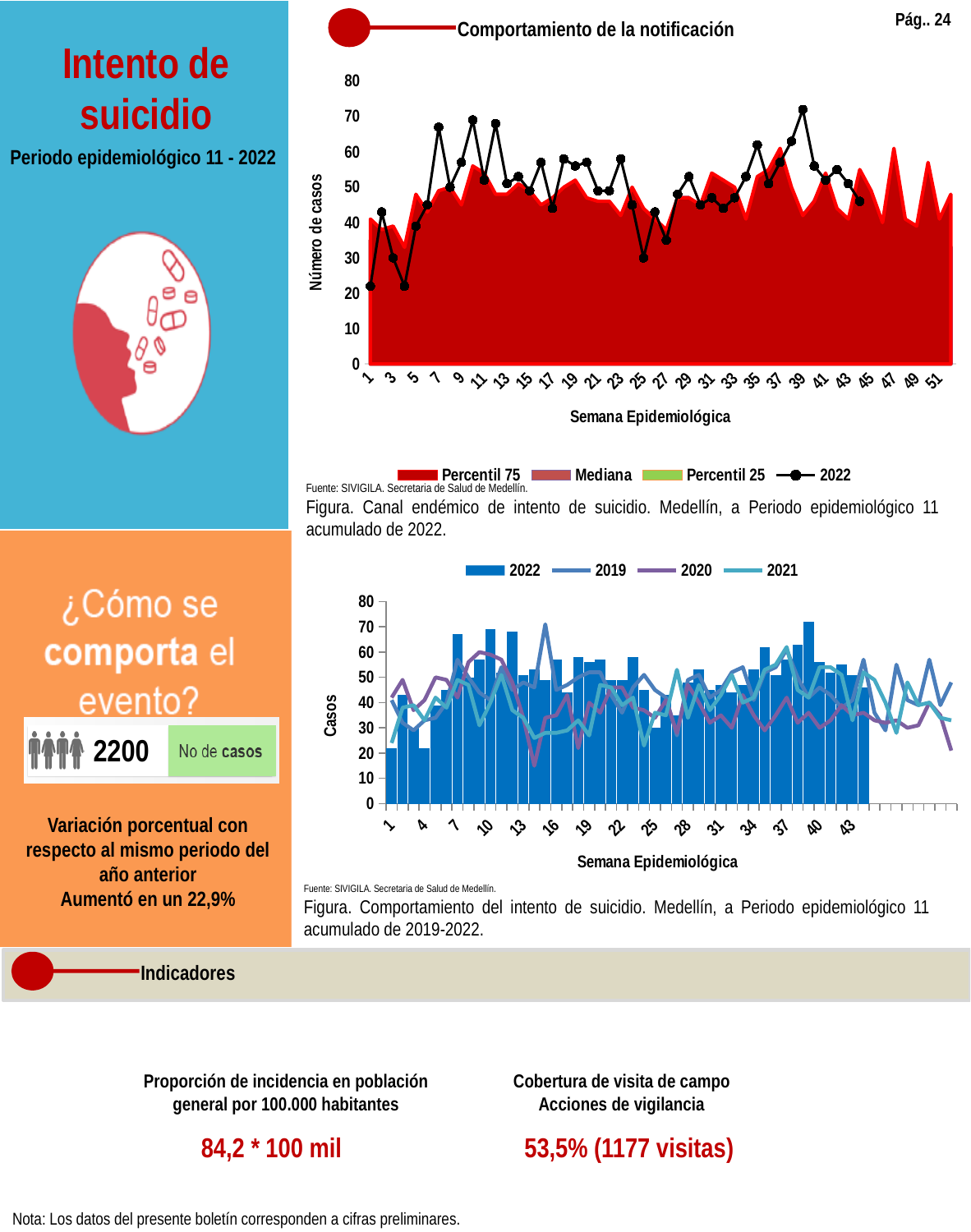
In the bottom chart, is the 2022 bar at week 1 greater or less than 30? less What is the y-axis title of the top chart? Número de casos In the top chart, what colour is the Percentil 75 series? red In the bottom chart, is the 2022 bar at week 40 greater or less than 60? less In the top chart, is the 2022 value at week 27 greater or less than 40? less In the bottom chart, which is larger for 2022: the bar at week 7 or the bar at week 4? week 7 In the bottom chart (Comportamiento del intento de suicidio 2019-2022), how many series does the legend list? 4 In the top chart, which is larger for the 2022 series: the value at week 7 or the value at week 27? week 7 In the top chart (Comportamiento de la notificación), how many series does the legend list? 4 In the bottom chart, what kind of chart is used to show the 2022 series? bar chart